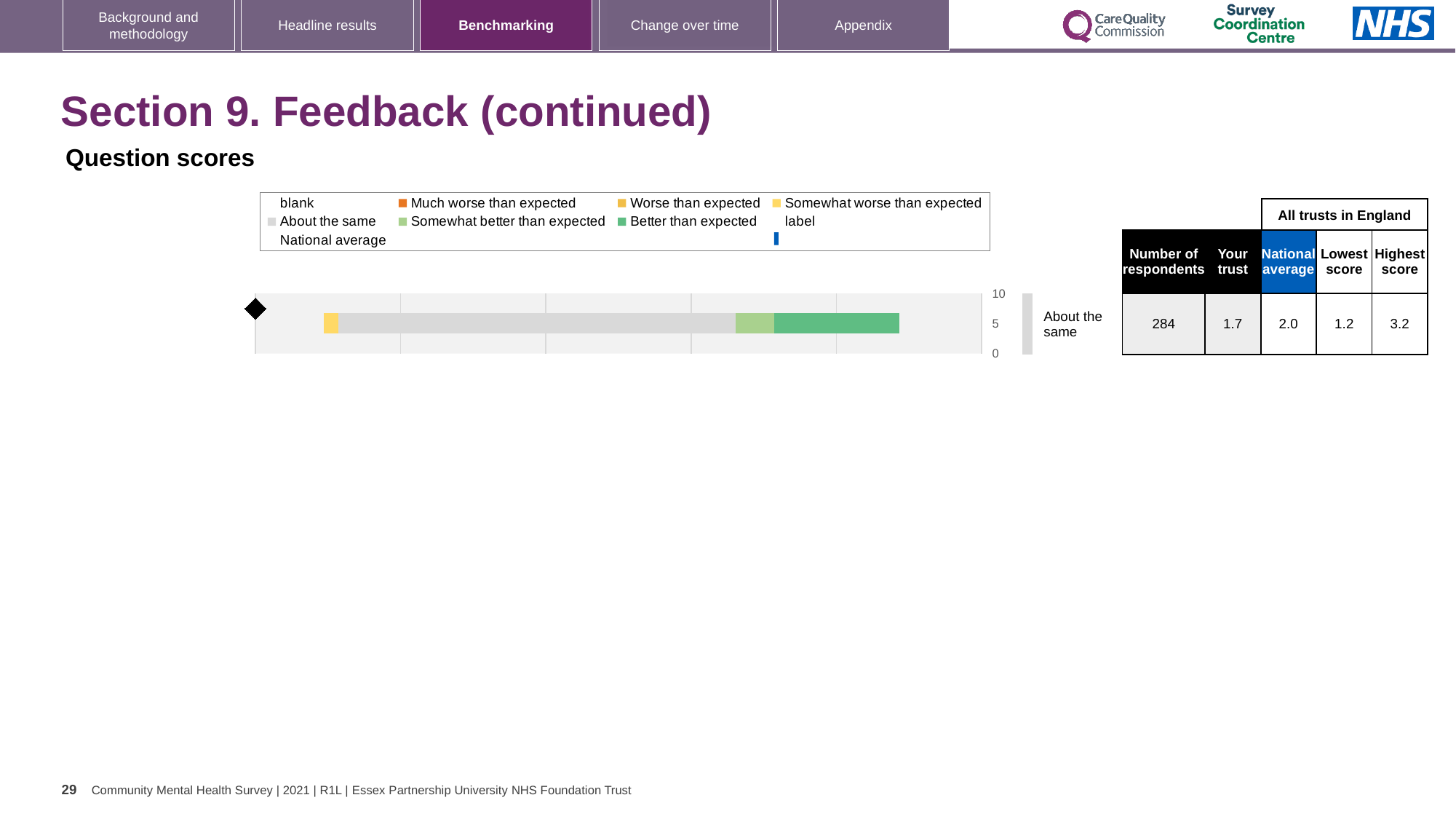
Which segment of the bar is the widest? About the same What is the category label of the bar in the chart? About the same Which legend entry is shown in orange? Much worse than expected In the table next to the chart, which is larger for 'About the same': the Your trust score or the National average? National average In the table next to the chart, what is the difference between the Highest score and the Lowest score for 'About the same'? 2.0 In the table next to the chart, how many respondents are listed for 'About the same'? 284 Is the 'About the same' segment of the bar wider or narrower than the 'Somewhat worse than expected' segment? Wider Is the 'Better than expected' segment of the bar wider or narrower than the 'Somewhat better than expected' segment? Wider In the table next to the chart, what is the National average score for 'About the same'? 2.0 What kind of chart is shown on the slide? Bar chart In the table next to the chart, what is the 'Your trust' score for 'About the same'? 1.7 How many bars are plotted in the chart? 1